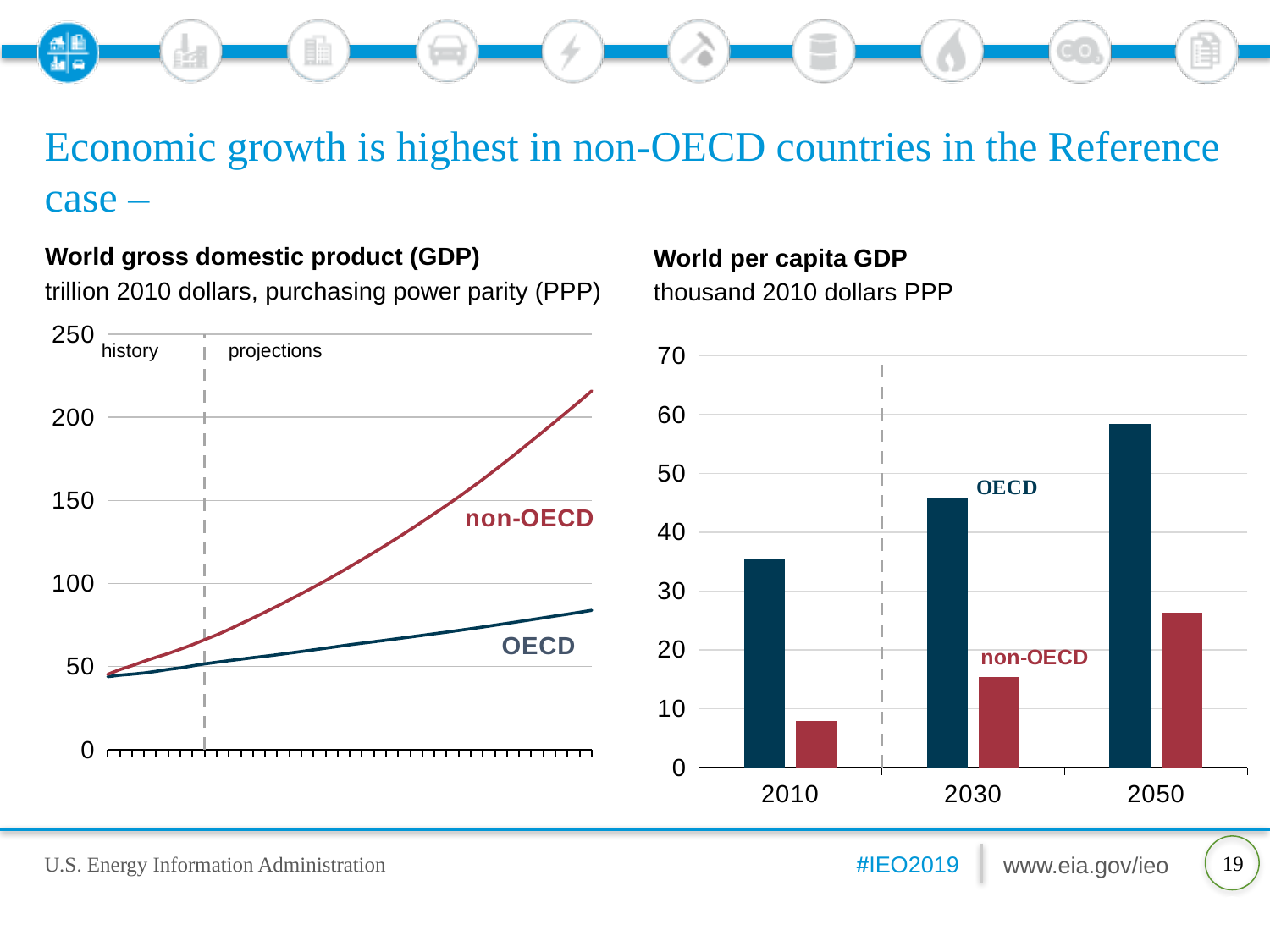
In the 'World per capita GDP' chart, do the OECD values rise or fall from 2010 to 2050? rise What kind of chart is the 'World per capita GDP' chart on the right? bar chart In the 'World gross domestic product (GDP)' chart, which series is higher at the end of the projection period, non-OECD or OECD? non-OECD In the 'World per capita GDP' chart, how many years are shown on the x axis? 3 In the 'World per capita GDP' chart, is the non-OECD value for 2010 greater or less than 10? less In the 'World per capita GDP' chart, how many series are plotted? 2 In the 'World per capita GDP' chart, is the OECD value for 2050 greater or less than 50? greater In the 'World per capita GDP' chart, is the non-OECD value for 2050 greater or less than 20? greater In the 'World per capita GDP' chart, which is larger in 2030, OECD or non-OECD? OECD What kind of chart is the 'World gross domestic product (GDP)' chart on the left? line chart